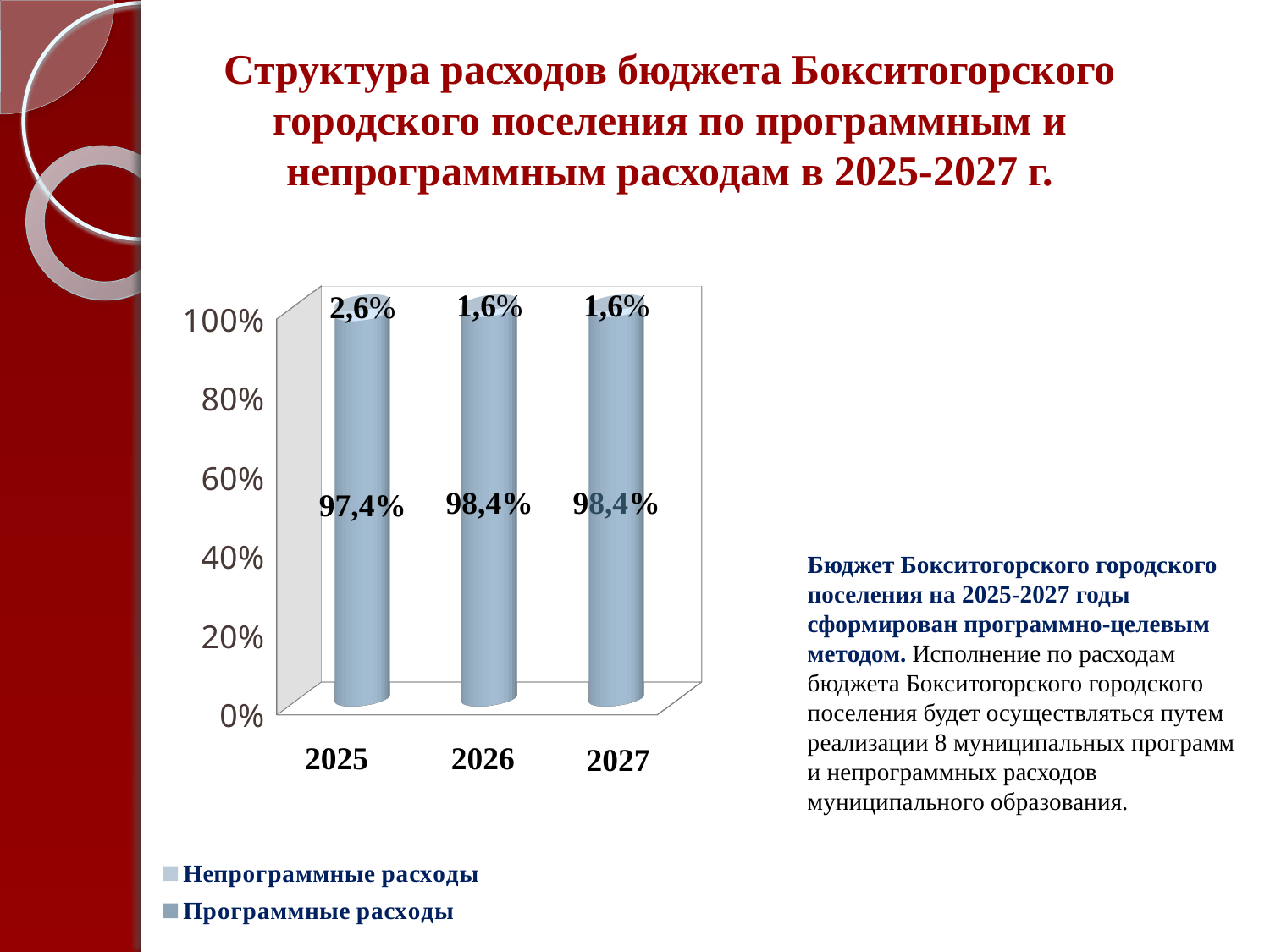
In which year is the share of Непрограммные расходы highest? 2025 What kind of chart is shown on the slide? Stacked bar chart Which is larger: the Непрограммные расходы share in 2025 or in 2026? 2025 What is the value for Программные расходы in 2026? 98,4% How many years are shown on the x axis? 3 In which year is the share of Программные расходы lowest? 2025 What is the value for Программные расходы in 2025? 97,4% What is the difference between the Программные расходы share in 2026 and in 2025? 1,0% What is the value for Непрограммные расходы in 2025? 2,6% What is the value for Непрограммные расходы in 2027? 1,6% How many series does the legend list? 2 Does the share of Непрограммные расходы rise or fall from 2025 to 2026? Fall